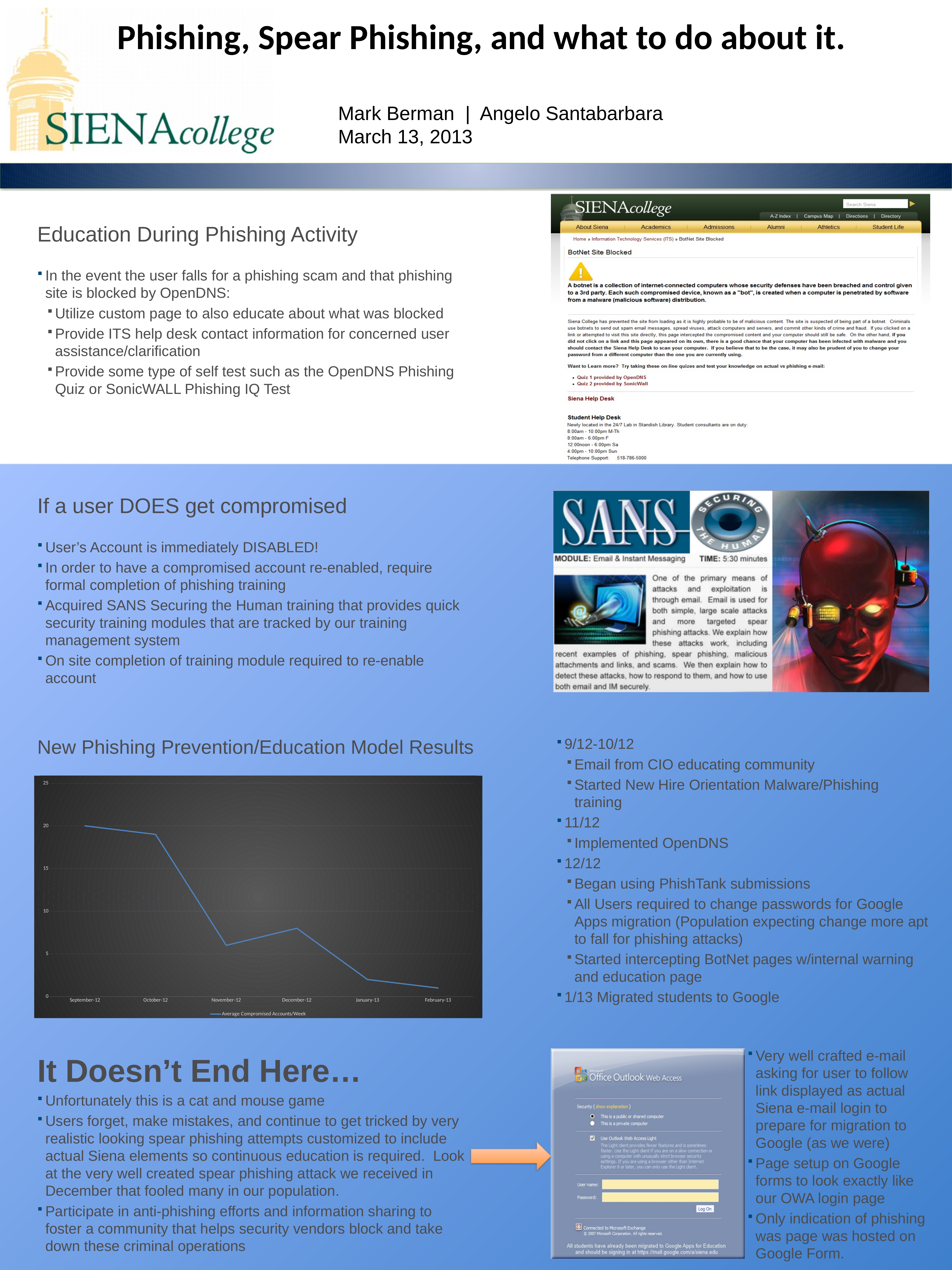
Is the value for October-12 in the line chart greater or less than 15? greater What is the highest value shown on the y axis of the line chart? 25 What kind of chart is shown under "New Phishing Prevention/Education Model Results"? line chart Which month has the lowest value in the line chart? February-13 Is the value for January-13 in the line chart greater or less than 5? less Is the value for November-12 in the line chart greater or less than 10? less Do the values in the line chart generally rise or fall from September-12 to February-13? fall How many series does the legend of the line chart list? 1 How many months are plotted along the x axis of the line chart? 6 Which month has the highest value in the line chart? September-12 What is the name of the series shown in the line chart's legend? Average Compromised Accounts/Week In the line chart, which is larger, the value for November-12 or the value for December-12? December-12